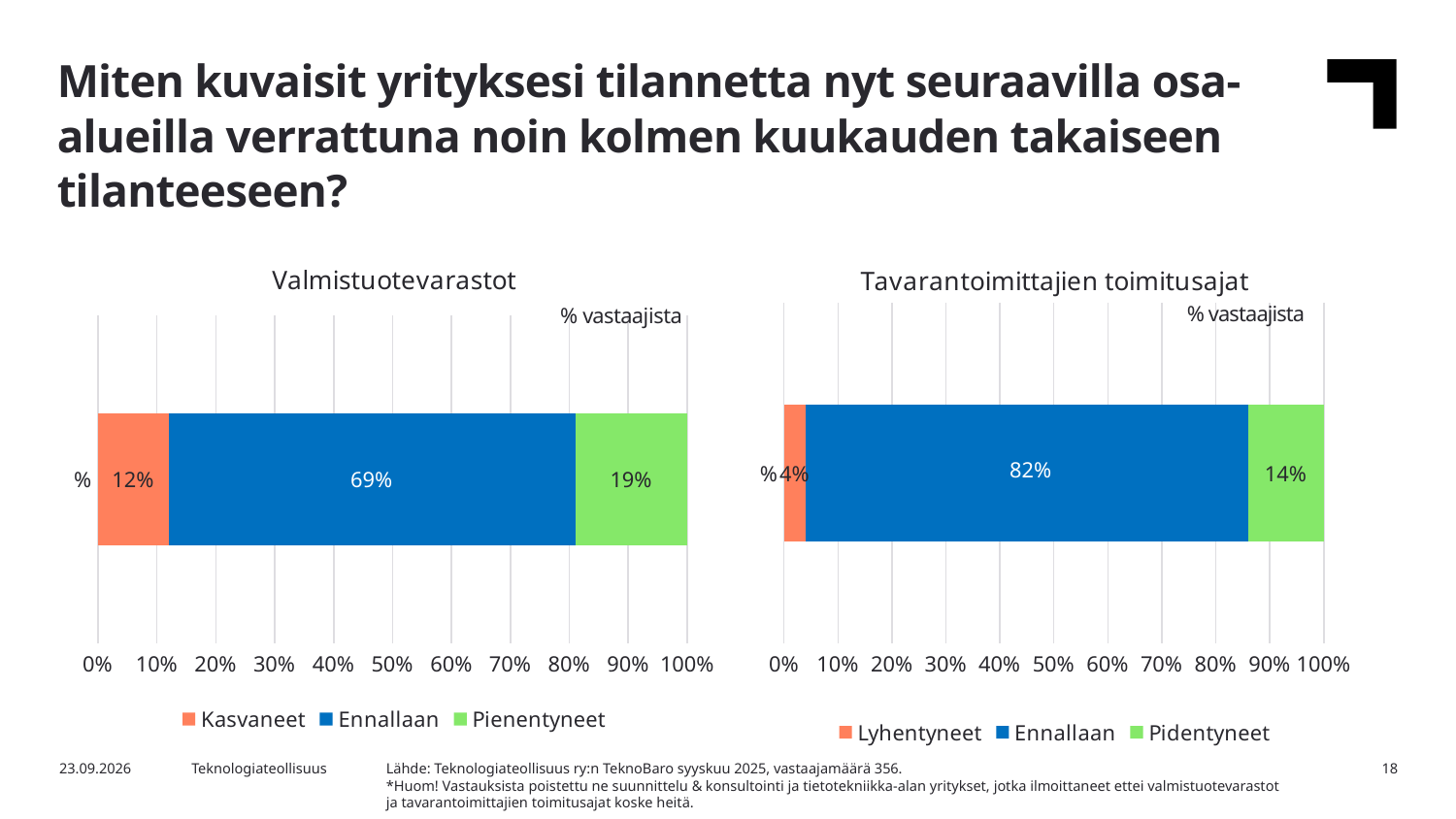
In the Valmistuotevarastot chart, what is the difference in percentage points between Pienentyneet and Kasvaneet? 7 In the Tavarantoimittajien toimitusajat chart, what is the total of the three segments of the stacked bar? 100% In the Tavarantoimittajien toimitusajat chart, which response category has the smallest share? Lyhentyneet How many series does the legend of the Valmistuotevarastot chart list? 3 In the Valmistuotevarastot chart, what percentage of respondents answered Kasvaneet? 12% In the Tavarantoimittajien toimitusajat chart, what percentage of respondents answered Lyhentyneet? 4% In the Valmistuotevarastot chart, what percentage of respondents answered Ennallaan? 69% What type of chart is the Tavarantoimittajien toimitusajat chart? Stacked bar chart In the Tavarantoimittajien toimitusajat chart, what percentage of respondents answered Pidentyneet? 14% What are the legend entries of the Tavarantoimittajien toimitusajat chart? Lyhentyneet, Ennallaan, Pidentyneet Which is larger: the Ennallaan share in the Valmistuotevarastot chart or the Ennallaan share in the Tavarantoimittajien toimitusajat chart? Tavarantoimittajien toimitusajat In the Valmistuotevarastot chart, which response category has the largest share? Ennallaan